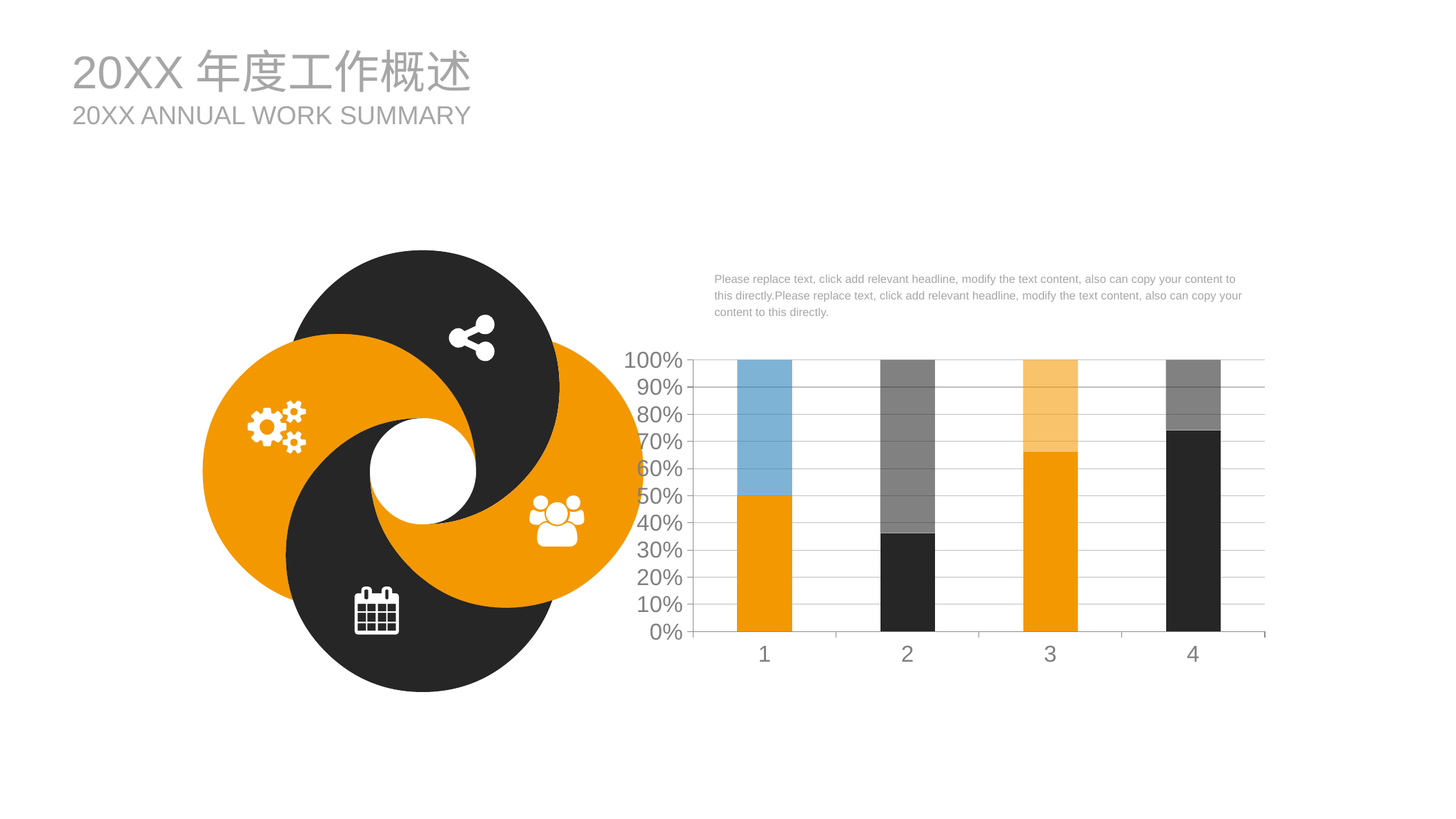
Which bar has the tallest bottom segment? 4 What is the total height of each stacked bar as shown on the y axis? 100% Is the bottom segment of bar 3 greater or less than 60%? greater Which bar has the shortest bottom segment? 2 Which bar has the larger bottom segment, bar 1 or bar 3? 3 Is the bottom segment of bar 4 greater or less than 60%? greater Is the bottom segment of bar 2 greater or less than 40%? less What kind of chart is shown on the slide? stacked bar chart What colour is the top segment of bar 1? blue What colour is the bottom segment of bar 1? orange How many categories are shown on the x axis of the chart? 4